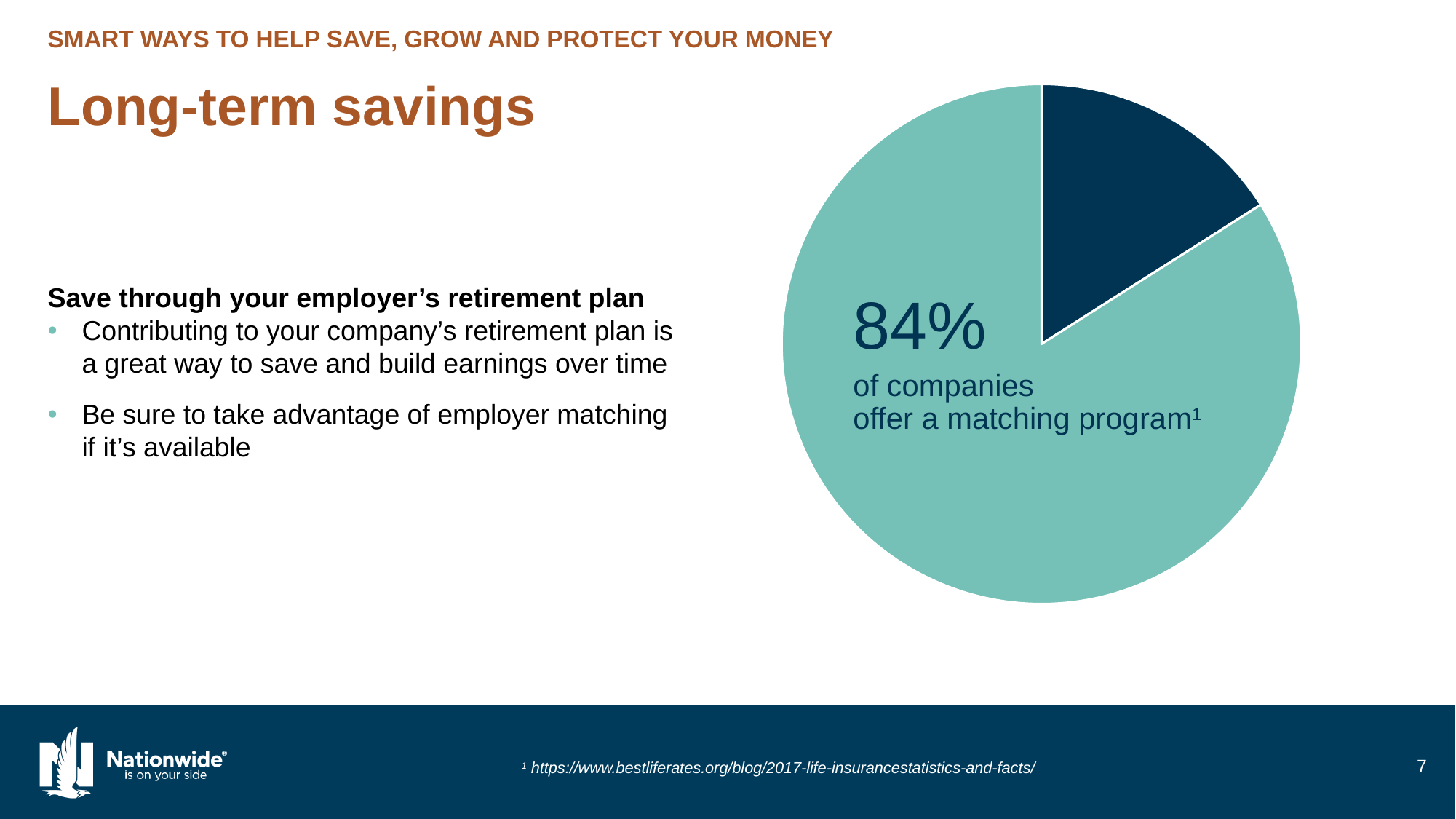
What is the title of the slide containing the pie chart? Long-term savings What colour is the slice representing the 84% of companies that offer a matching program? Teal What kind of chart is shown on the slide? Pie chart Which slice of the pie chart is the largest? The slice for companies that offer a matching program (84%) Which slice of the pie chart is larger, the teal slice or the dark navy slice? The teal slice What percentage of companies offer a matching program, according to the pie chart? 84% Which slice of the pie chart is the smallest? The dark navy slice What share of the pie does the slice for companies that offer a matching program represent? 84% How many slices does the pie chart have? 2